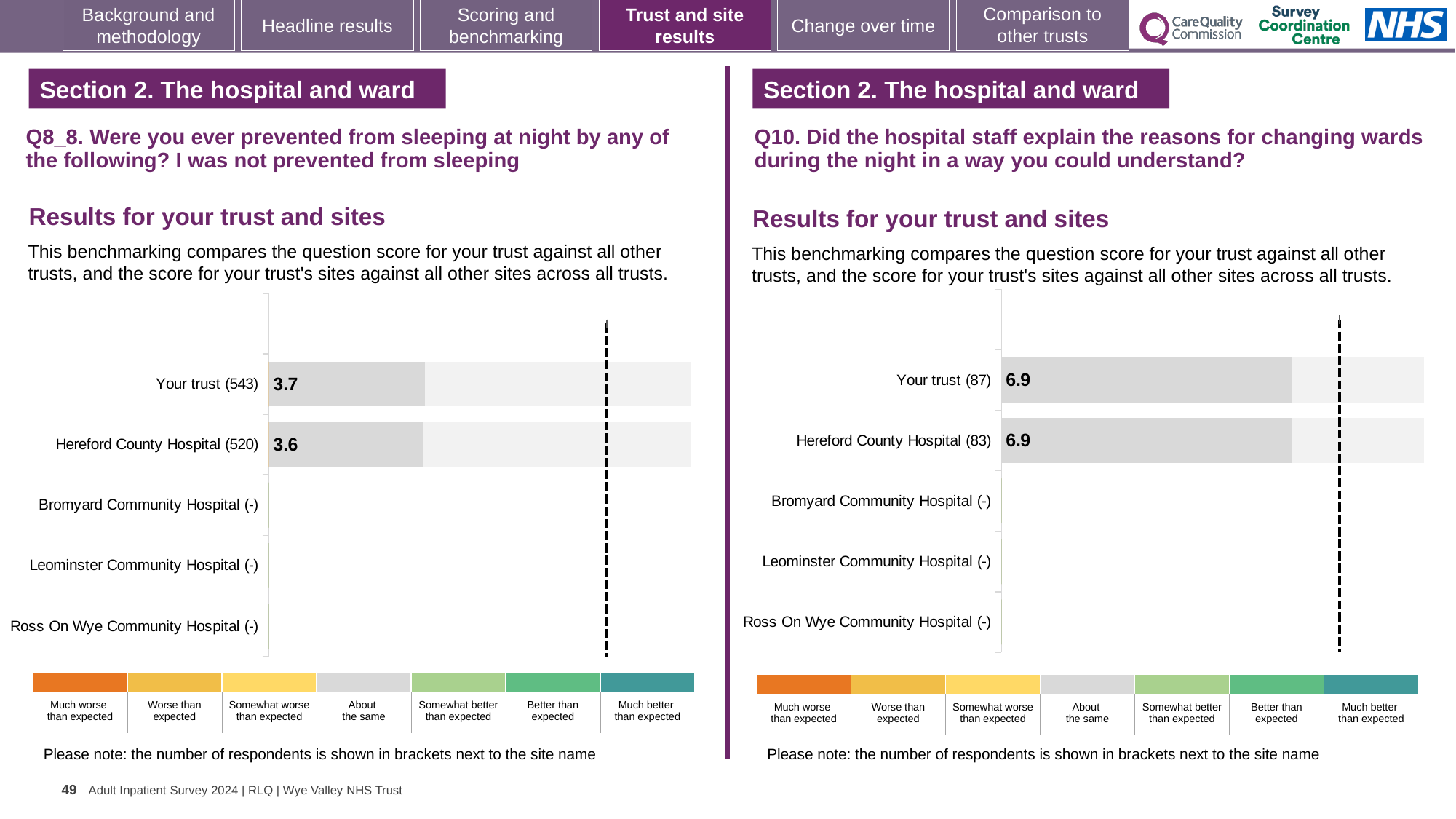
In the left chart (Q8_8), how many respondents are shown in brackets for Your trust? 543 In the left chart (Q8_8), what is the difference between the score for Your trust and the score for Hereford County Hospital? 0.1 In the left chart (Q8_8), which has the higher score, Your trust or Hereford County Hospital? Your trust In the right chart (Q10), what is the score for Your trust? 6.9 In the left chart (Q8_8), what is the score for Your trust? 3.7 In the left chart (Q8_8), which of the plotted sites has the lowest score? Hereford County Hospital In the right chart (Q10), how many sites have a plotted score bar? 2 How many categories (sites) are listed on the y axis of the left chart (Q8_8)? 5 What kind of chart is used in the right chart (Q10)? Bar chart In the right chart (Q10), what is the score for Hereford County Hospital? 6.9 In the right chart (Q10), how many respondents are shown in brackets for Hereford County Hospital? 83 In the left chart (Q8_8), what is the score for Hereford County Hospital? 3.6